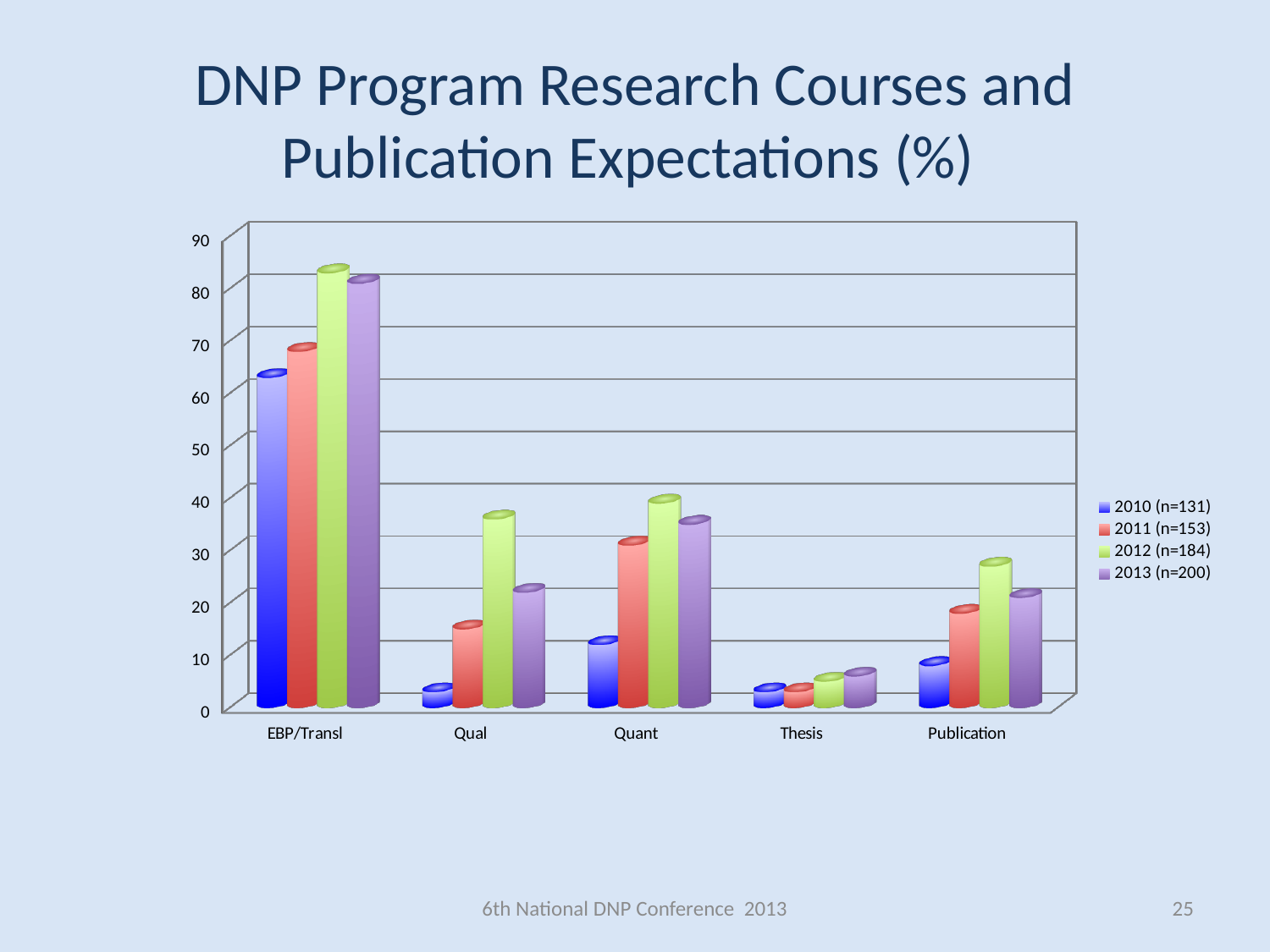
Is the value for EBP/Transl in the 2012 (n=184) series greater or less than 70? greater Which category has the lowest value for the 2012 (n=184) series? Thesis How many series does the chart's legend list? 4 Is the value for Quant in the 2011 (n=153) series greater or less than 20? greater What is the legend entry for the 2013 series? 2013 (n=200) Which category has the highest value for the 2012 (n=184) series? EBP/Transl Is the value for EBP/Transl in the 2010 (n=131) series greater or less than 50? greater What kind of chart is shown on the slide? Bar chart For the Publication category, which series has the larger value: 2012 (n=184) or 2013 (n=200)? 2012 (n=184) How many categories are shown along the x axis of the chart? 5 In the 2011 (n=153) series, which is larger: the value for Quant or the value for Qual? Quant